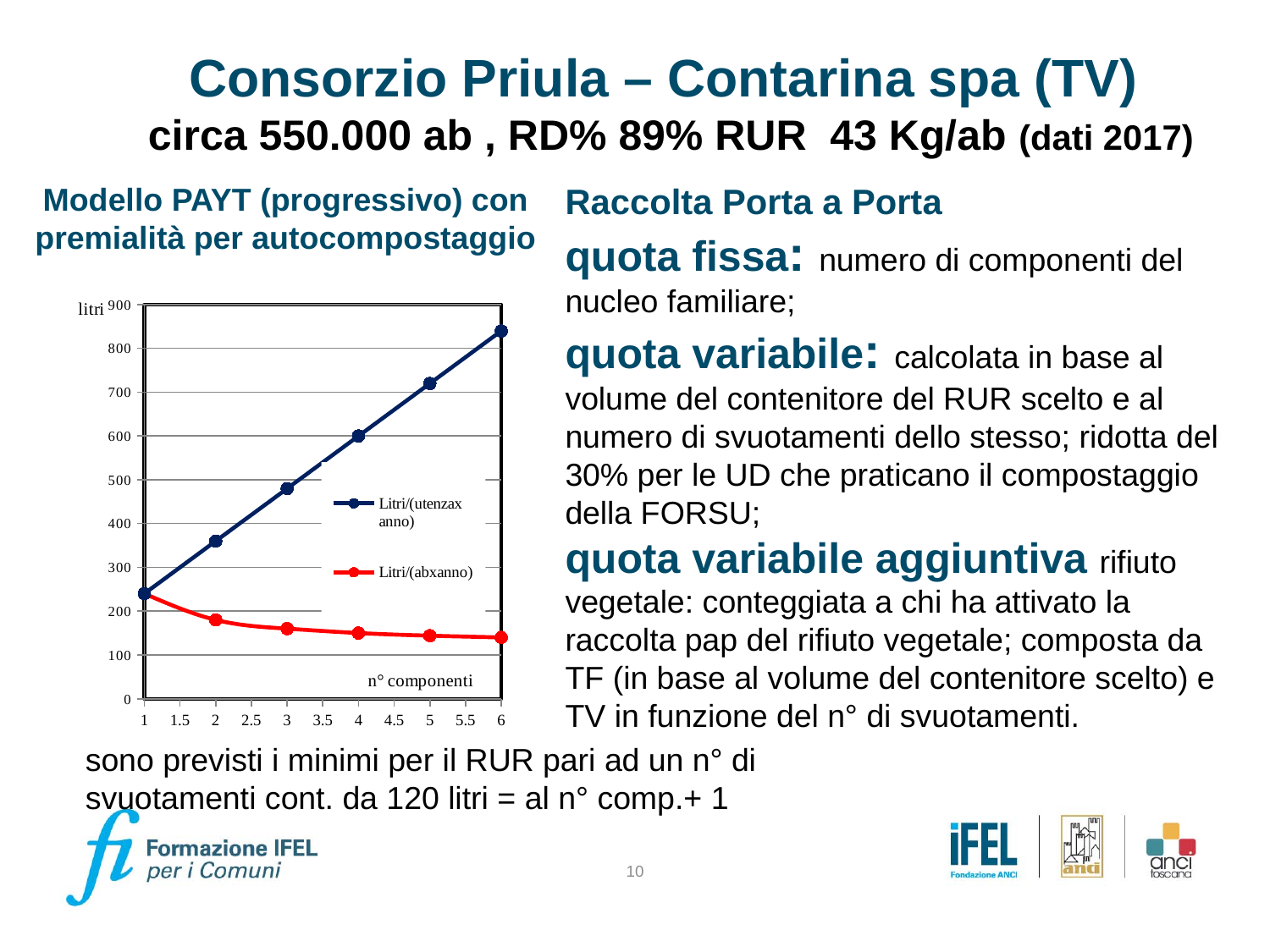
What kind of chart is shown on the slide? line chart What is the label of the x axis of the chart? n° componenti What are the two series named in the chart's legend? Litri/(utenzax anno) and Litri/(abxanno) Does the Litri/(utenzax anno) series rise or fall as the number of components increases? rises At which number of components does the Litri/(utenzax anno) series reach its highest value? 6 Is the value of Litri/(utenzax anno) at 6 components greater or less than 800? greater How many series does the chart's legend list? 2 Does the Litri/(abxanno) series rise or fall as the number of components increases? falls Is the value of Litri/(utenzax anno) at 2 components greater or less than 300? greater Is the value of Litri/(abxanno) at 6 components greater or less than 200? less At 6 components, which series has the higher value, Litri/(utenzax anno) or Litri/(abxanno)? Litri/(utenzax anno) What is the value of Litri/(utenzax anno) at 4 components? 600